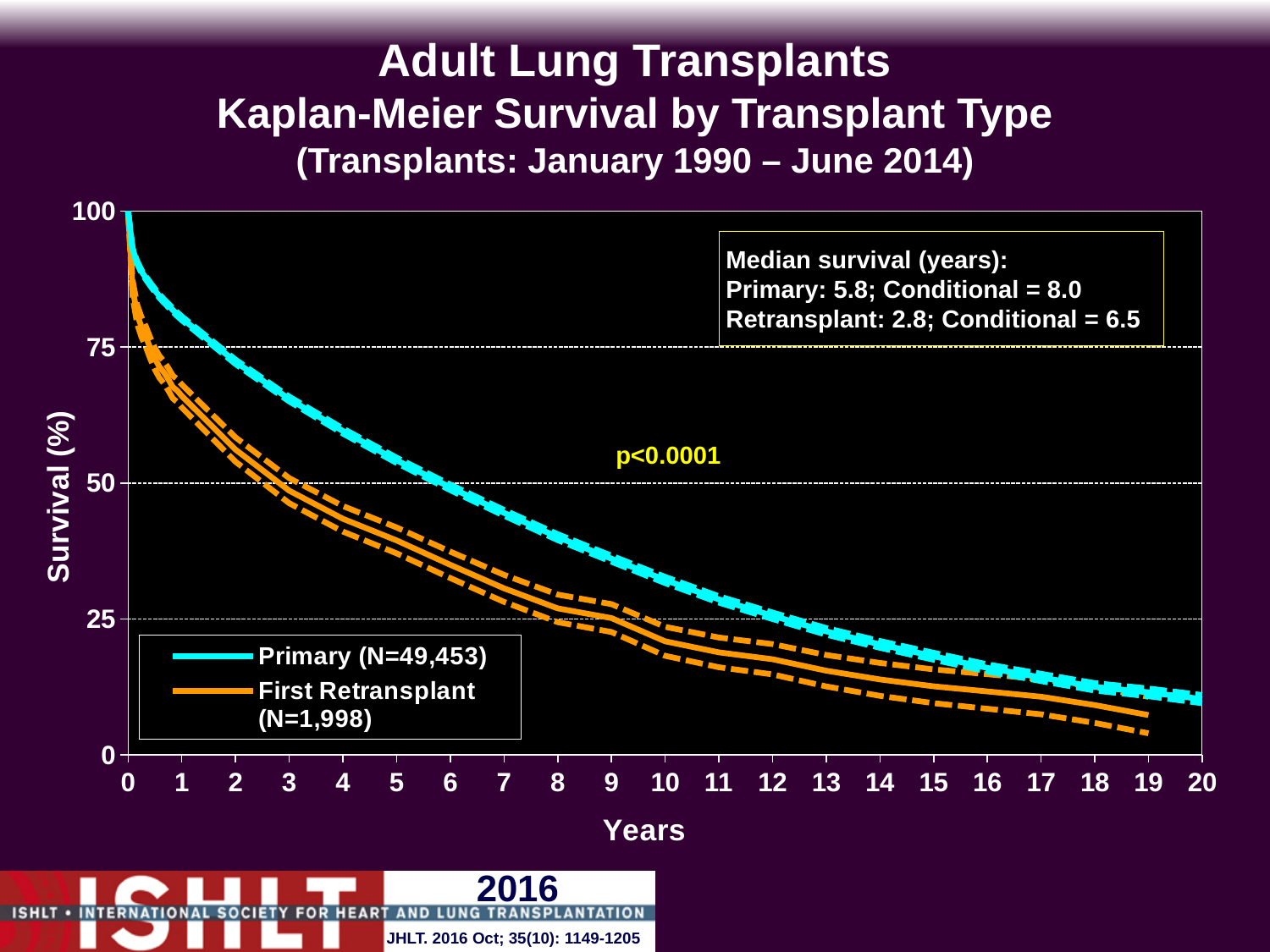
Which series has higher survival at 5 years, Primary or First Retransplant? Primary What kind of chart is shown on the slide? line chart Do the survival curves rise or fall as years increase? fall Is the survival value for First Retransplant at 4 years greater or less than 50? less Is the survival value for Primary at 1 year greater or less than 75? greater What is the median survival in years for Primary transplants? 5.8 What is the median survival in years for Retransplant? 2.8 What is the N for the Primary series shown in the legend? 49,453 How many series does the legend list? 2 What is the conditional median survival in years for Primary transplants? 8.0 Is the survival value for Primary at 15 years greater or less than 25? less What is the conditional median survival in years for Retransplant? 6.5